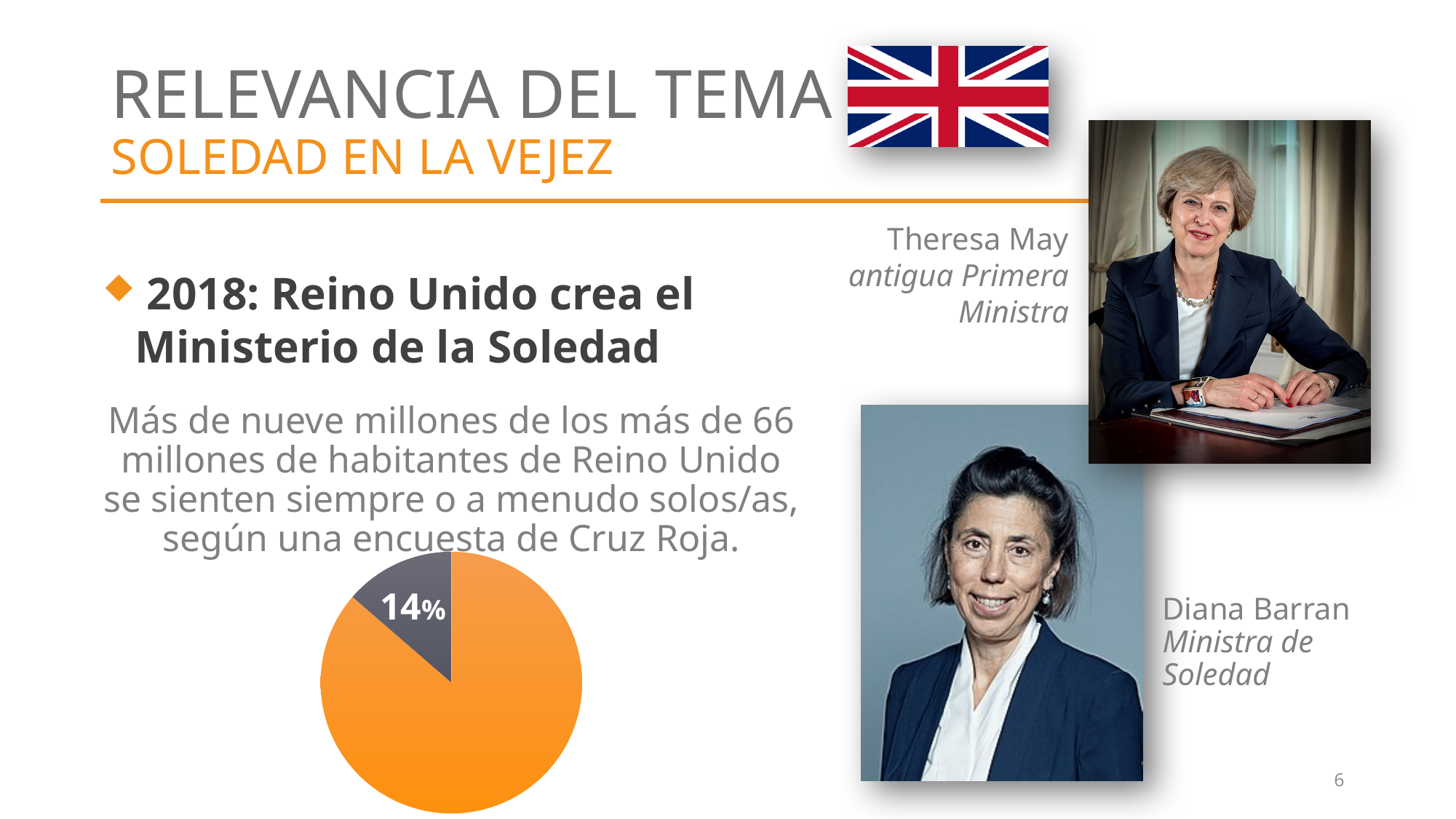
How many data labels are printed on the pie chart? 1 What share of the pie does the grey slice represent? 14% What share of the pie does the orange slice represent? 86% Which slice of the pie chart is larger, the orange one or the grey one? orange What kind of chart is shown on the slide? pie chart What colour is the slice labelled 14% in the pie chart? grey How many slices does the pie chart have? 2 Which slice of the pie chart is the largest? the orange slice What value is printed on the grey slice of the pie chart? 14% Which slice of the pie chart is the smallest? the grey slice (14%)